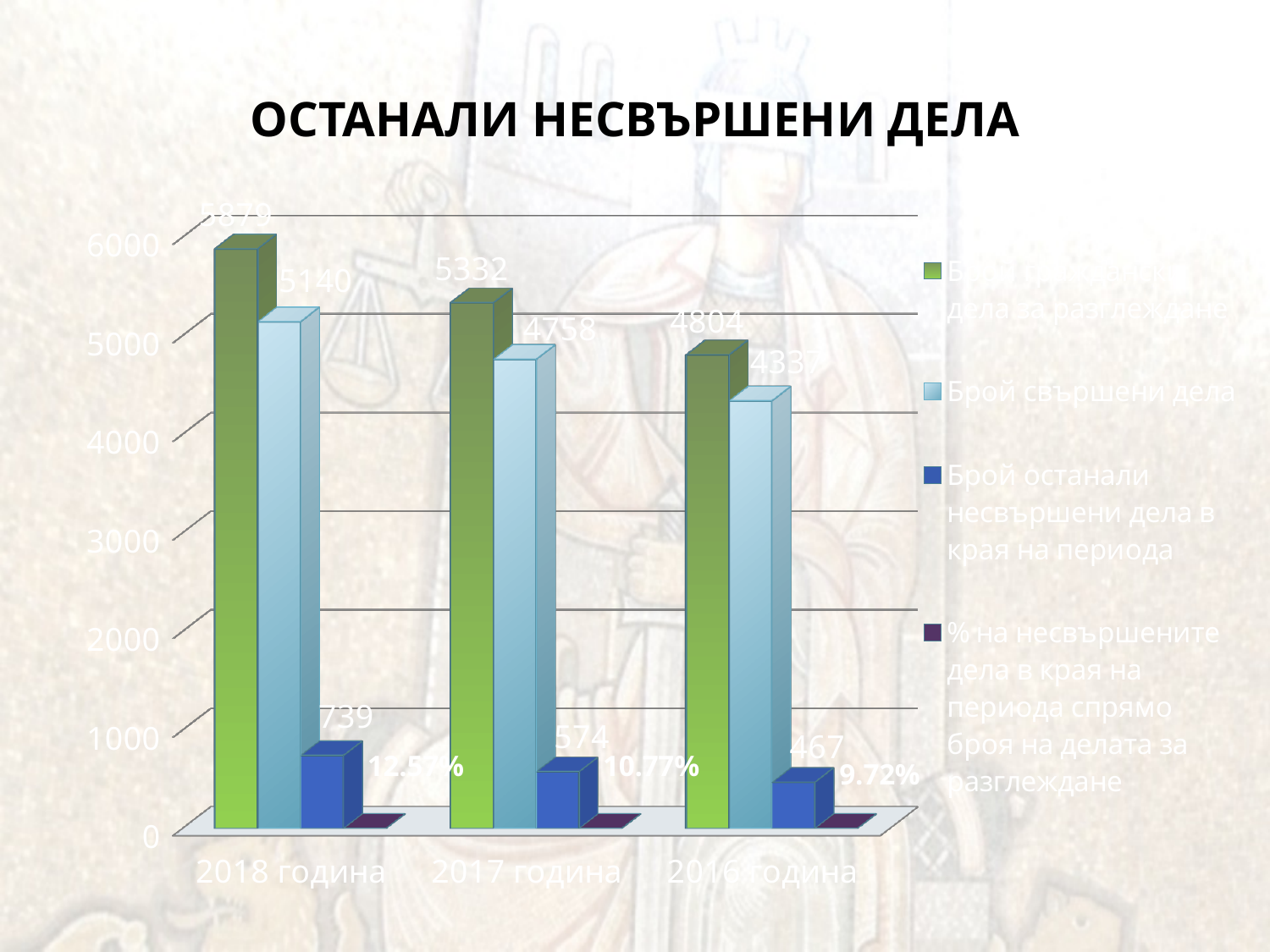
Which year has the highest value for "Брой свършени дела"? 2018 година Which year has the lowest value for "Брой останали несвършени дела в края на периода"? 2016 година What is the value of the green series (cases for consideration) for 2017 година? 5332 Which year has the larger value for "Брой останали несвършени дела в края на периода": 2017 година or 2016 година? 2017 година What is the title of the chart? ОСТАНАЛИ НЕСВЪРШЕНИ ДЕЛА What is the value of "Брой свършени дела" for 2018 година? 5140 How many series does the legend list? 4 What percentage of unfinished cases (the purple series) is shown for 2016 година? 9.72% How many year categories are shown on the x axis? 3 What is the value of "Брой останали несвършени дела в края на периода" for 2017 година? 574 Do the values of "Брой свършени дела" rise or fall from 2018 година to 2016 година along the x axis? fall What is the difference between the number of unfinished cases in 2018 година (739) and in 2016 година (467)? 272